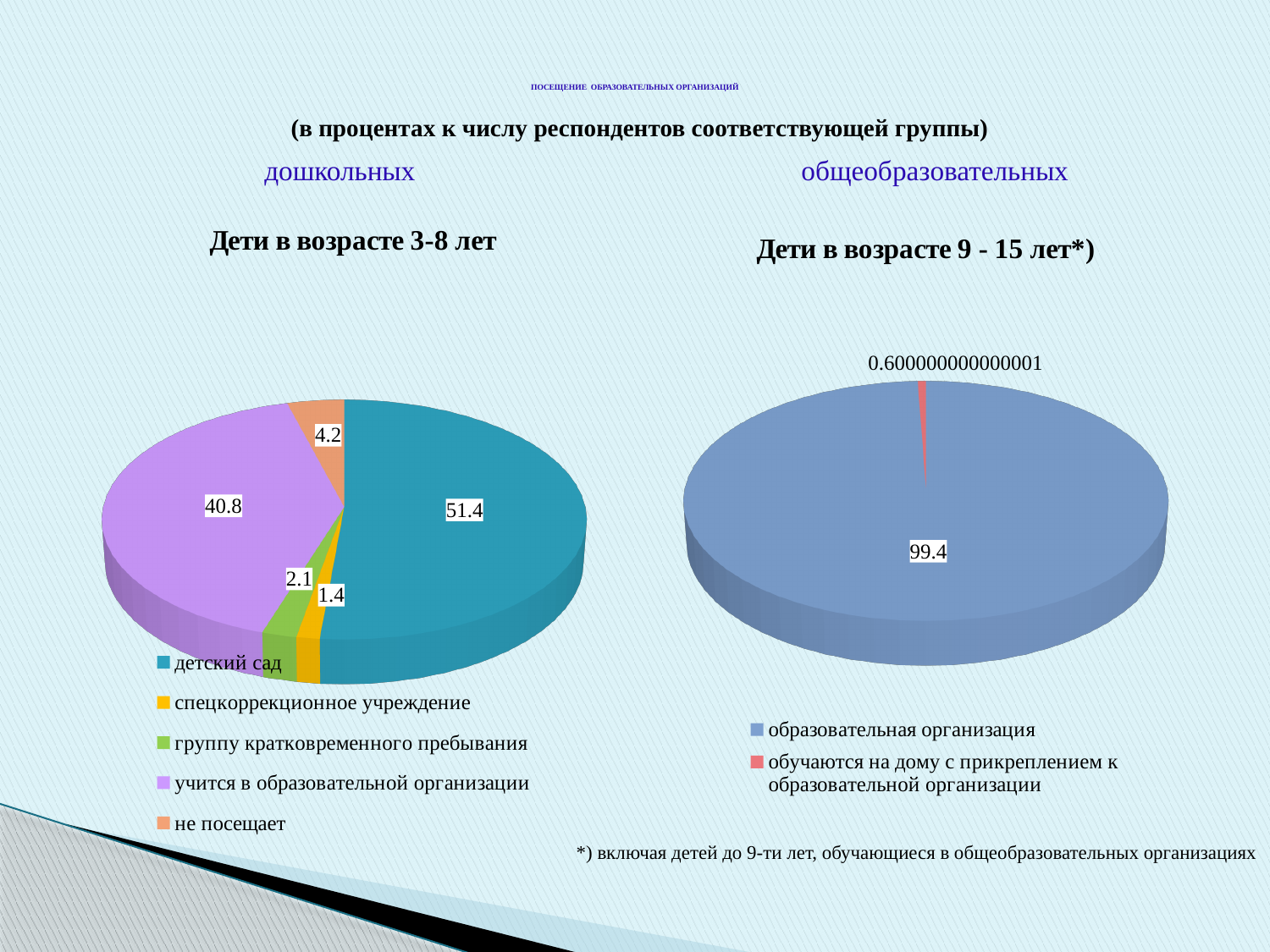
In the chart titled "Дети в возрасте 3-8 лет", what is the value for "детский сад"? 51.4 In the chart titled "Дети в возрасте 9 - 15 лет*)", what is the value for "обучаются на дому с прикреплением к образовательной организации"? 0.600000000000001 In the chart titled "Дети в возрасте 9 - 15 лет*)", what is the value for "образовательная организация"? 99.4 What kind of chart is the chart titled "Дети в возрасте 9 - 15 лет*)"? pie chart In the chart titled "Дети в возрасте 3-8 лет", which is larger: "группу кратковременного пребывания" or "не посещает"? не посещает In the chart titled "Дети в возрасте 3-8 лет", what is the difference between the values for "детский сад" and "учится в образовательной организации"? 10.6 In the chart titled "Дети в возрасте 3-8 лет", which category has the smallest slice? спецкоррекционное учреждение In the chart titled "Дети в возрасте 3-8 лет", what is the value for "учится в образовательной организации"? 40.8 In the chart titled "Дети в возрасте 3-8 лет", what is the value for "спецкоррекционное учреждение"? 1.4 In the chart titled "Дети в возрасте 3-8 лет", what is the value for "не посещает"? 4.2 In the chart titled "Дети в возрасте 3-8 лет", which category has the largest slice? детский сад How many categories does the legend of the chart titled "Дети в возрасте 3-8 лет" list? 5